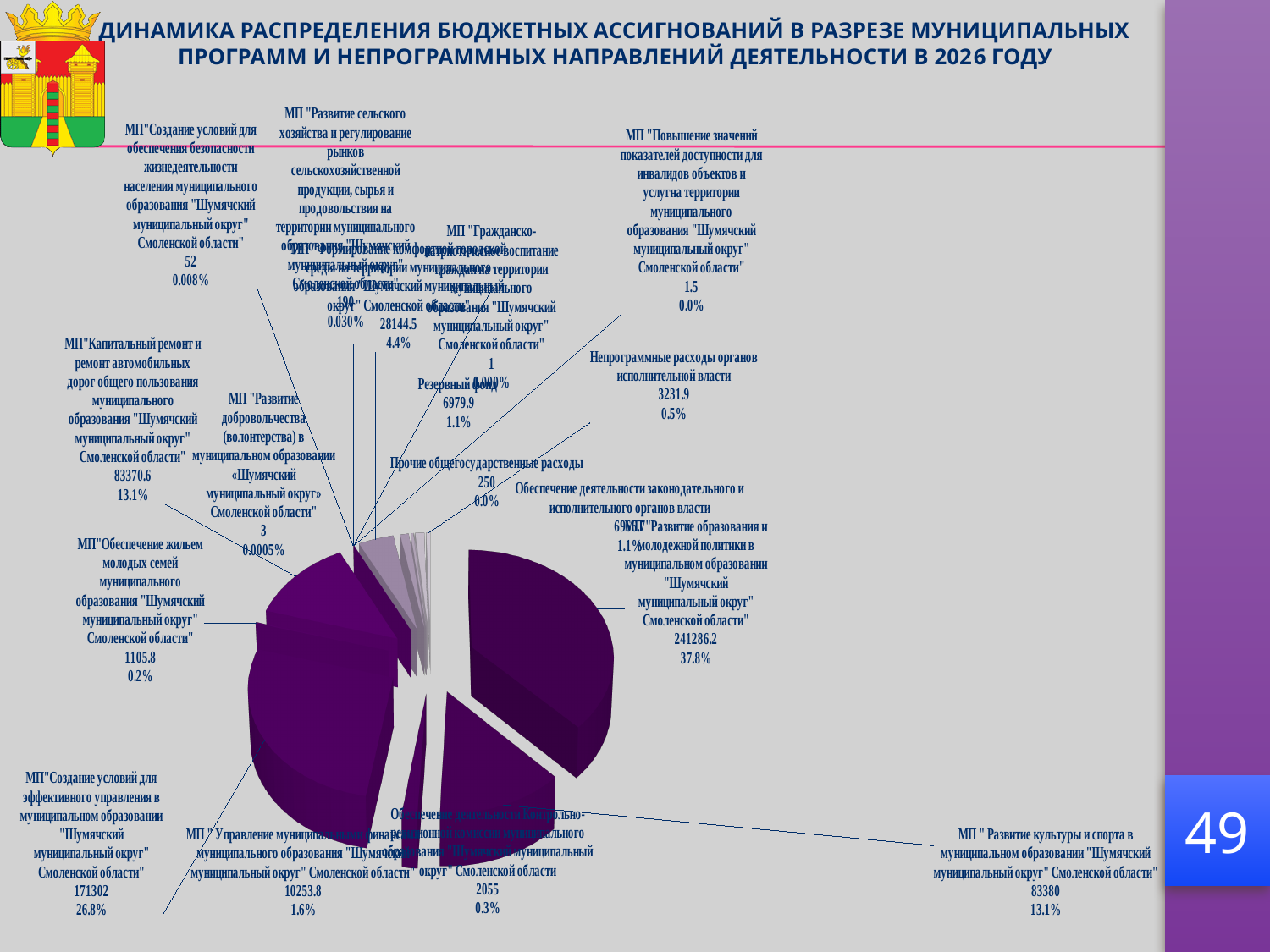
What value is shown for Резервный фонд? 6979.9 What share of the pie does МП "Создание условий для эффективного управления в муниципальном образовании "Шумячский муниципальный округ" Смоленской области" account for? 26.8% What value is shown for МП "Развитие культуры и спорта в муниципальном образовании "Шумячский муниципальный округ" Смоленской области"? 83380 What share of the pie does МП "Развитие образования и молодежной политики" account for? 37.8% What value is shown for Непрограммные расходы органов исполнительной власти? 3231.9 What is the difference between the value for МП "Развитие образования и молодежной политики" (241286.2) and the value for МП "Создание условий для эффективного управления" (171302)? 69984.2 What kind of chart is shown on the slide? pie chart Which is larger: the value for МП "Создание условий для эффективного управления" or the value for МП "Капитальный ремонт и ремонт автомобильных дорог общего пользования"? МП "Создание условий для эффективного управления" Which category has the largest share of the pie? МП "Развитие образования и молодежной политики в муниципальном образовании "Шумячский муниципальный округ" Смоленской области" What value is shown for МП "Управление муниципальными финансами муниципального образования "Шумячский муниципальный округ" Смоленской области"? 10253.8 What value is shown for МП "Развитие образования и молодежной политики в муниципальном образовании "Шумячский муниципальный округ" Смоленской области"? 241286.2 What share of the pie does МП "Обеспечение жильем молодых семей муниципального образования "Шумячский муниципальный округ" Смоленской области" account for? 0.2%